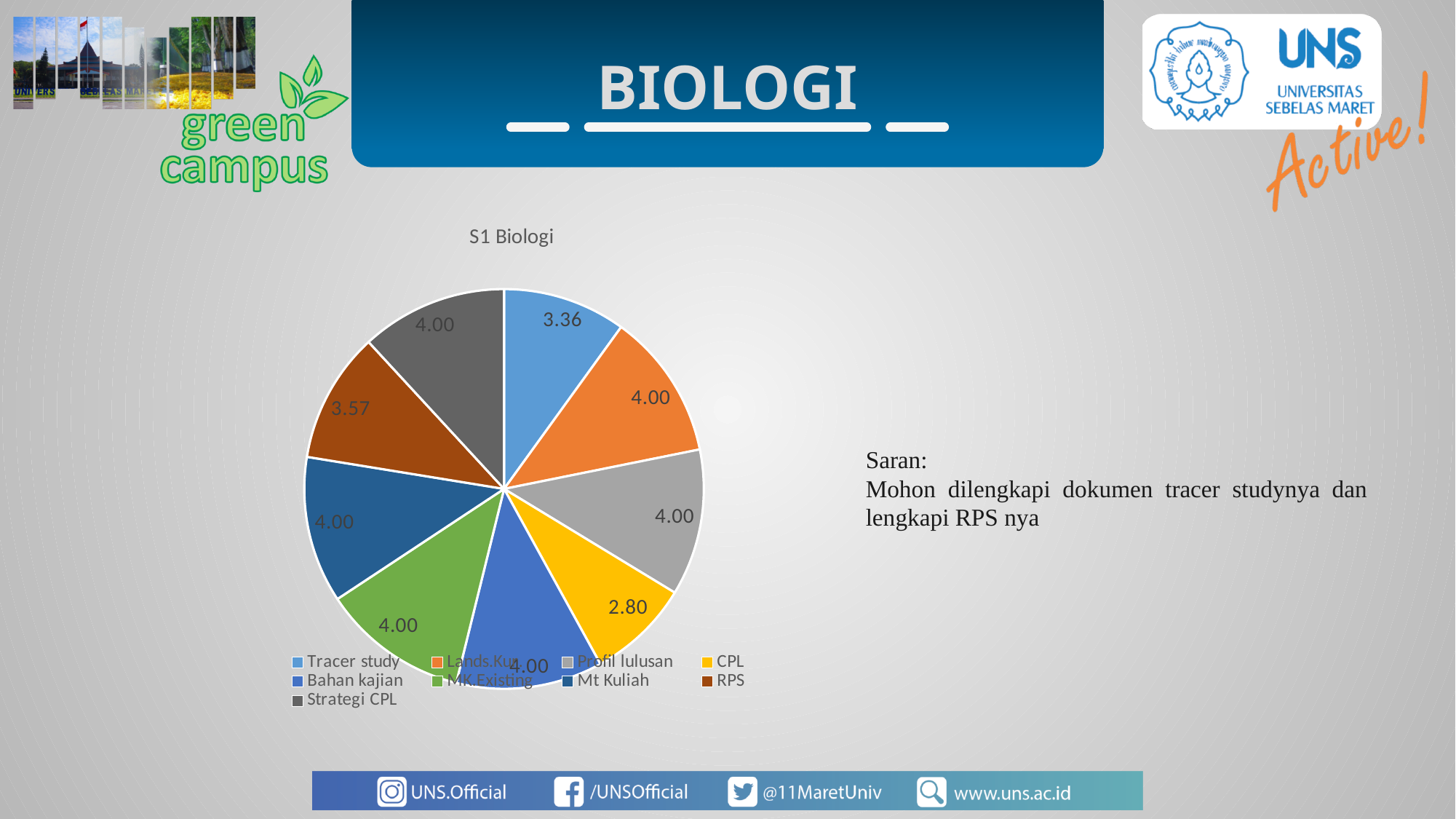
Which category has the smallest slice in the S1 Biologi pie chart? CPL How many slices does the S1 Biologi pie chart have? 9 Which is larger in the S1 Biologi pie chart, the CPL value or the Profil lulusan value? Profil lulusan What is the value of the Lands.Kur slice in the S1 Biologi pie chart? 4.00 What is the value of the CPL slice in the S1 Biologi pie chart? 2.80 What is the title of the chart on the slide? S1 Biologi Which is larger in the S1 Biologi pie chart, the RPS value or the Tracer study value? RPS What is the difference between the RPS value and the CPL value in the S1 Biologi pie chart? 0.77 What kind of chart is shown on the slide? Pie chart What is the value of the RPS slice in the S1 Biologi pie chart? 3.57 What is the difference between the Tracer study value and the CPL value in the S1 Biologi pie chart? 0.56 What is the value of the Tracer study slice in the S1 Biologi pie chart? 3.36